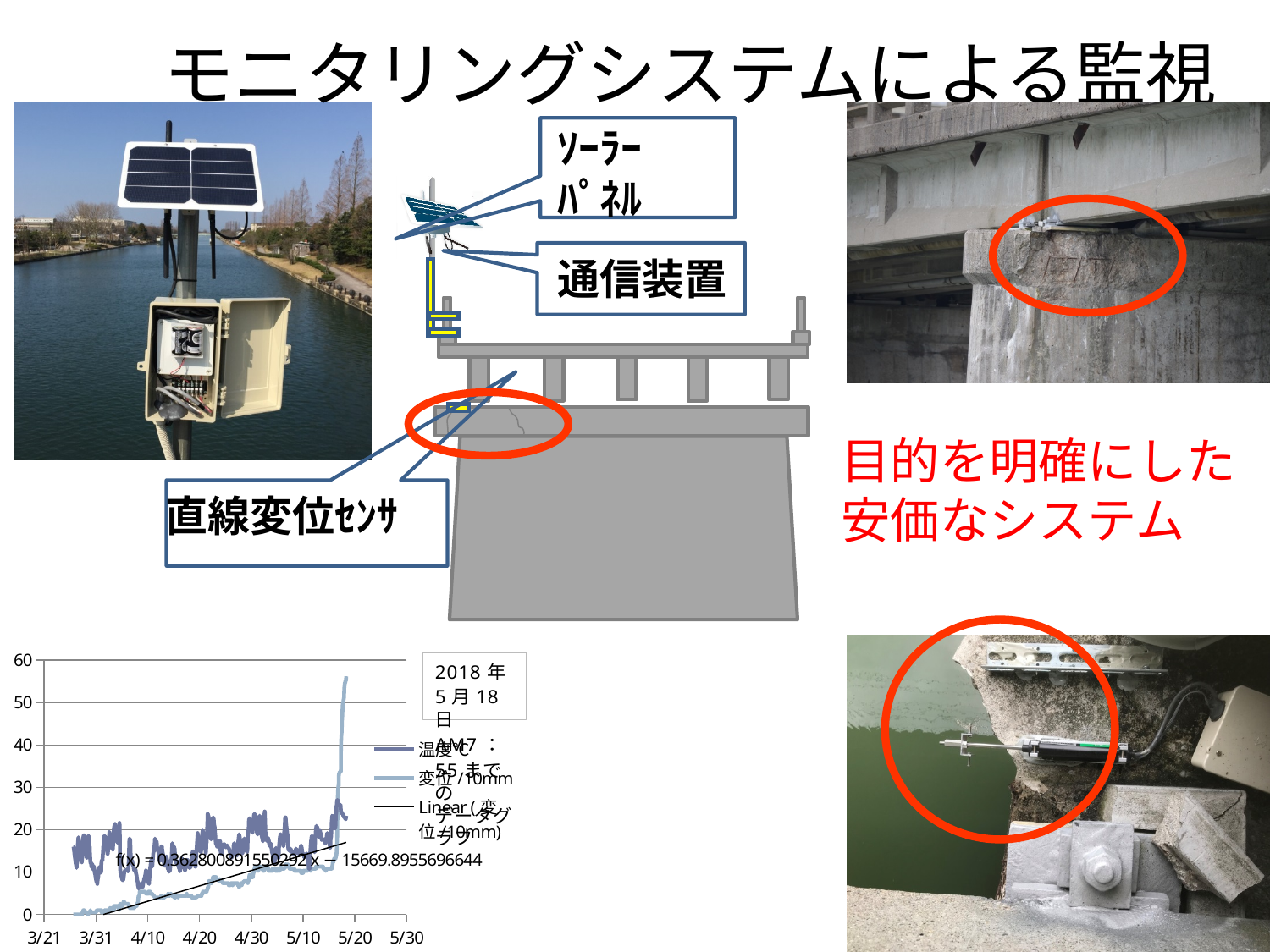
What is the first date label on the x axis of the bottom-left chart? 3/21 What is the trendline equation printed on the bottom-left chart? f(x) = 0.362800891550292 x − 15669.8955696644 What are the legend entries of the bottom-left chart? 温度℃, 変位/10mm, Linear(変位/10mm) In the bottom-left chart, does the 変位/10mm series rise or fall toward the end of the period (around 5/18)? rise How many date labels are shown on the x axis of the bottom-left chart? 8 In the bottom-left chart, is the peak value of the 変位/10mm series greater or less than 50? greater What is the highest value shown on the y axis of the bottom-left chart? 60 In the bottom-left chart, is the 温度℃ value around 4/20 greater or less than 30? less In the bottom-left chart, is the 変位/10mm value around 4/10 greater or less than 10? less What kind of chart is shown at the bottom left of the slide? line chart In the bottom-left chart, which series reaches the highest value, 温度℃ or 変位/10mm? 変位/10mm How many series does the legend of the bottom-left chart list? 3